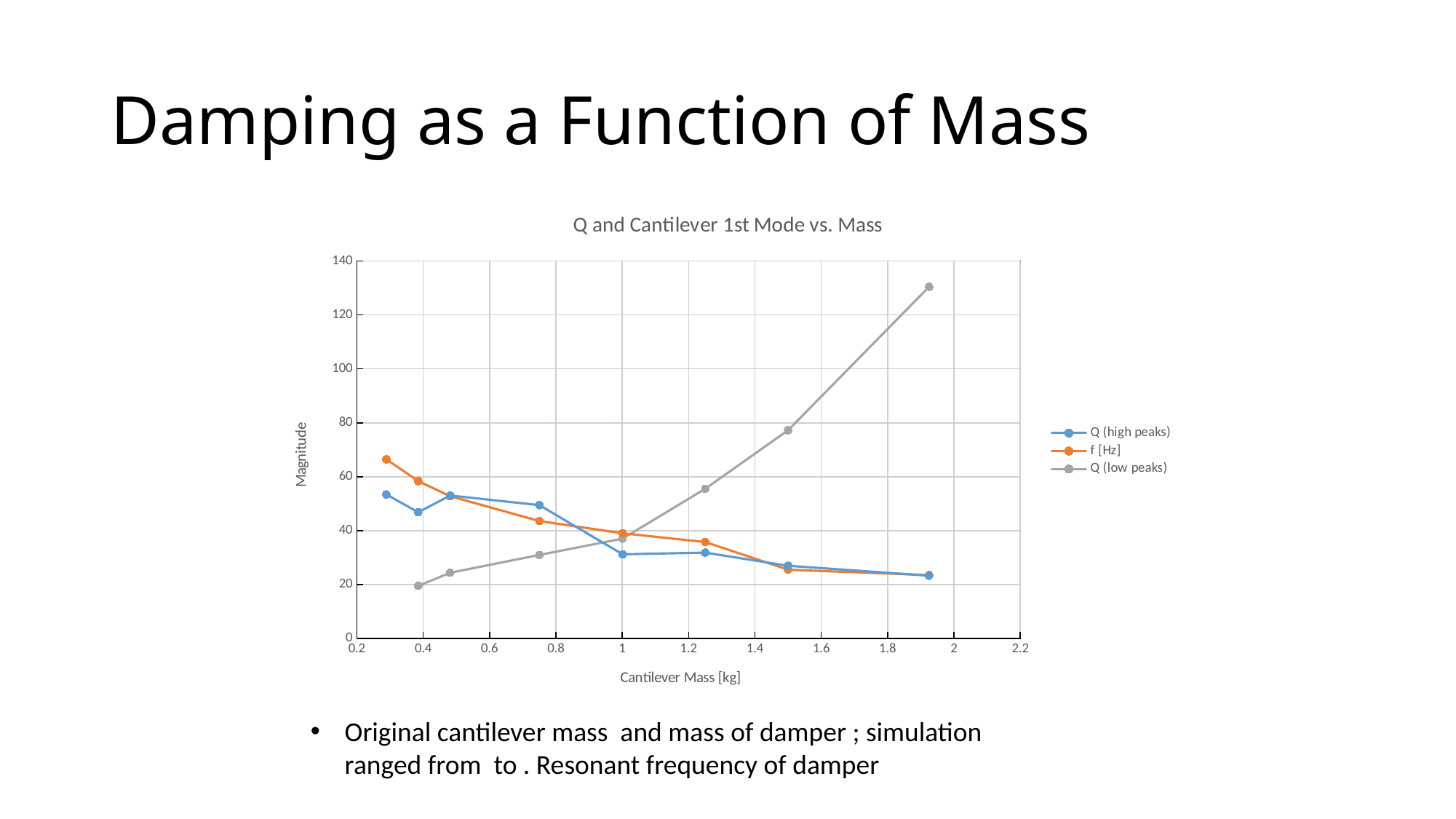
At the lowest cantilever mass plotted, which is larger: f [Hz] or Q (high peaks)? f [Hz] What kind of chart is shown on the slide? line chart What is the title of the chart? Q and Cantilever 1st Mode vs. Mass How many series does the legend list? 3 Which series reaches the highest value on the chart? Q (low peaks) Is the highest value of the Q (low peaks) series greater or less than 120? greater Does the Q (low peaks) series rise or fall as cantilever mass increases? rise What is the label of the x axis? Cantilever Mass [kg] Is the value of Q (low peaks) at a cantilever mass of about 1.25 kg greater or less than 60? less At the largest cantilever mass plotted, which is larger: Q (low peaks) or f [Hz]? Q (low peaks) Is the first value of the f [Hz] series (at the lowest mass) greater or less than 60? greater Does the f [Hz] series rise or fall as cantilever mass increases? fall